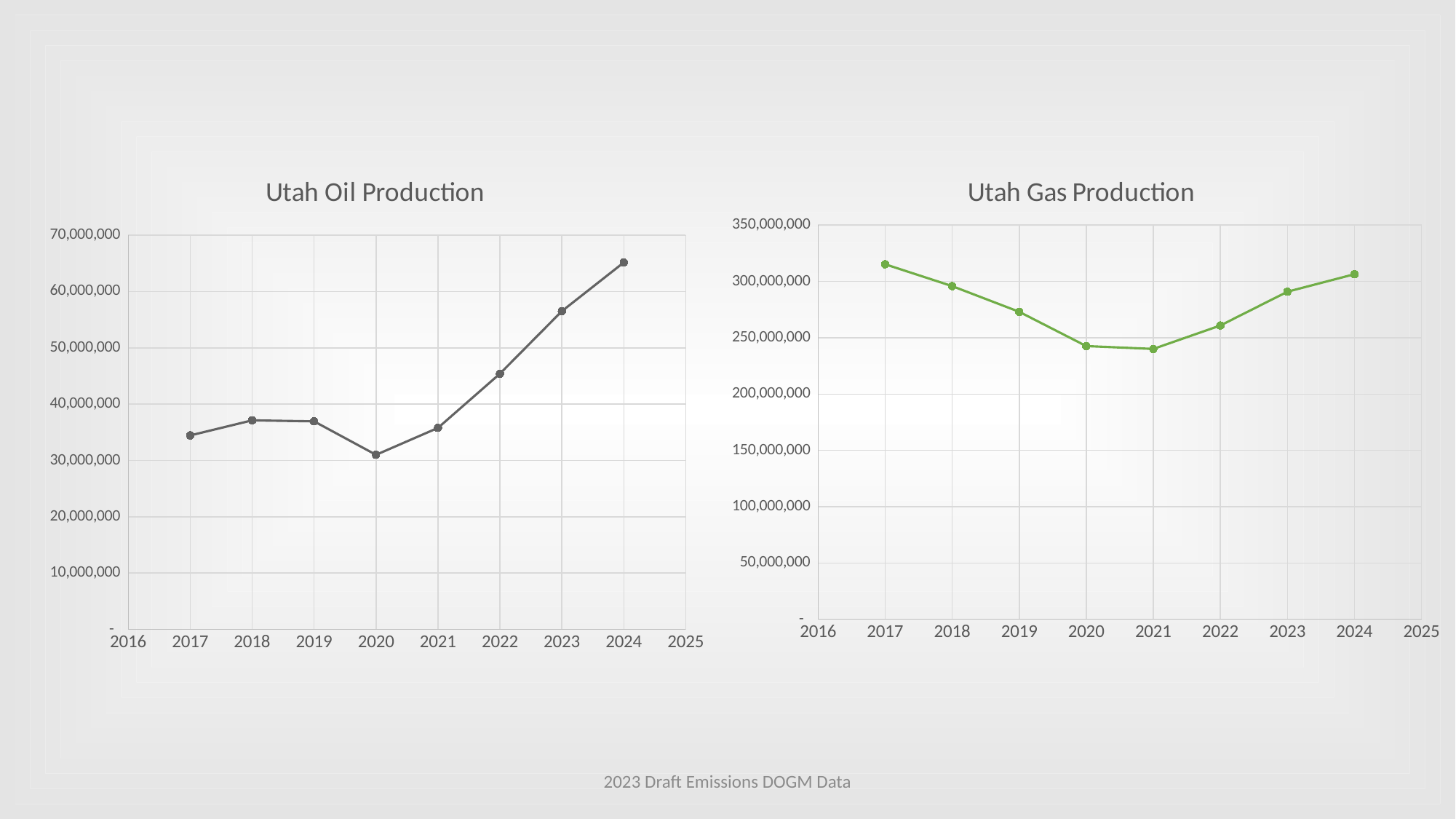
On the Utah Oil Production chart, is the value for 2024 greater or less than 60,000,000? greater On the Utah Oil Production chart, is the value for 2017 greater or less than 40,000,000? less On the Utah Oil Production chart, which year has the lowest value? 2020 On the Utah Gas Production chart, is the value for 2020 greater or less than 250,000,000? less On the Utah Gas Production chart, which is larger, the value for 2017 or the value for 2020? 2017 What kind of chart is the Utah Oil Production chart? line chart What is the source note shown at the bottom of the slide? 2023 Draft Emissions DOGM Data How many data points are plotted on the Utah Gas Production chart? 8 On the Utah Gas Production chart, do values rise or fall from 2017 to 2021? fall On the Utah Oil Production chart, do values rise or fall from 2020 to 2024? rise On the Utah Oil Production chart, which year has the highest value? 2024